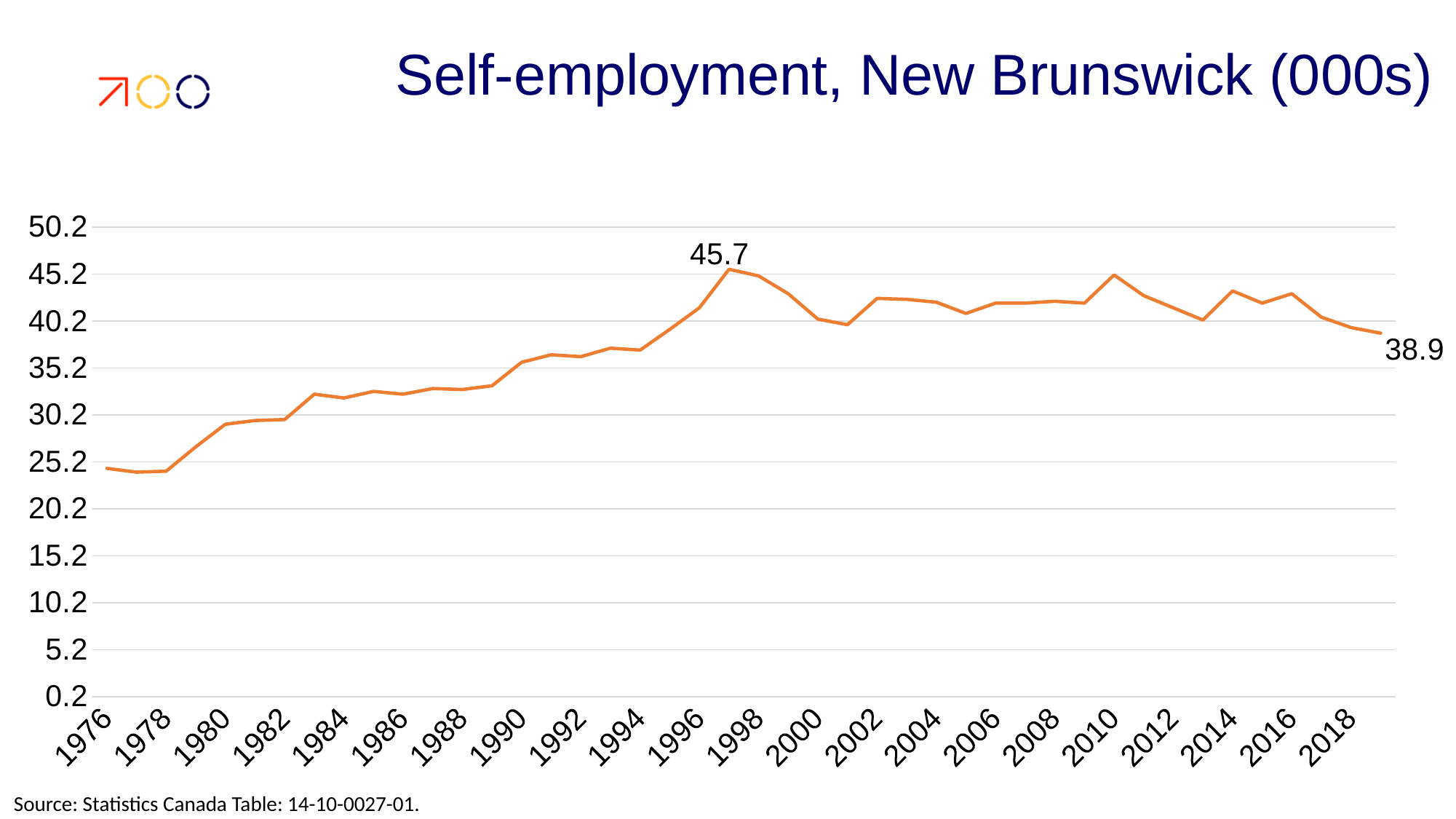
Does the line generally rise or fall between 1976 and 1996? rise Which is larger, the labelled peak value or the labelled final value? the peak value (45.7) What source is cited for the chart data? Statistics Canada Table: 14-10-0027-01 How many year labels are shown on the x axis? 22 What value is labelled at the final point of the line? 38.9 What is the title of the chart? Self-employment, New Brunswick (000s) Is the value for 1976 greater or less than 30.2? less What is the difference between the labelled peak value and the labelled final value? 6.8 Is the value for 1984 greater or less than 35.2? less What is the highest value labelled on the line? 45.7 Is the value for 2010 greater or less than 40.2? greater What type of chart is shown on the slide? line chart